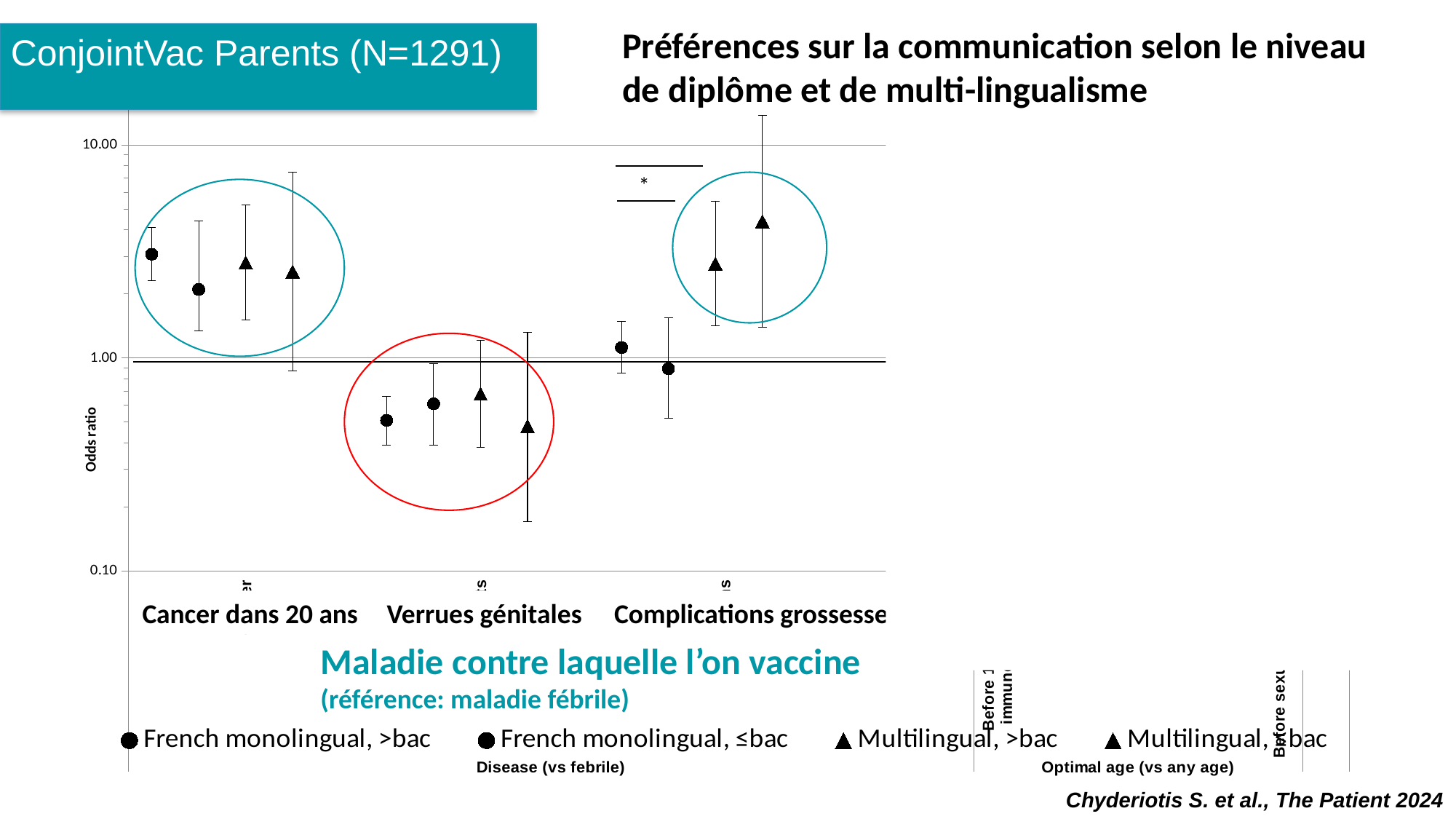
For Complications grossesse, which has the higher odds ratio: Multilingual, >bac or Multilingual, ≤bac? Multilingual, ≤bac Which disease category is the reference category for the odds ratios? maladie fébrile How many disease categories are shown on the x axis? 3 What kind of chart is shown on the slide? Scatter chart with error bars For Cancer dans 20 ans, which has the higher odds ratio: French monolingual, >bac or French monolingual, ≤bac? French monolingual, >bac How many series does the legend list? 4 Is the odds ratio for French monolingual, ≤bac for Verrues génitales greater or less than 1.00? less Is the odds ratio for French monolingual, >bac for Cancer dans 20 ans greater or less than 1.00? greater What is the label of the y axis? Odds ratio For Complications grossesse, which series has the highest odds ratio? Multilingual, ≤bac Is the odds ratio for Multilingual, ≤bac for Complications grossesse greater or less than 1.00? greater